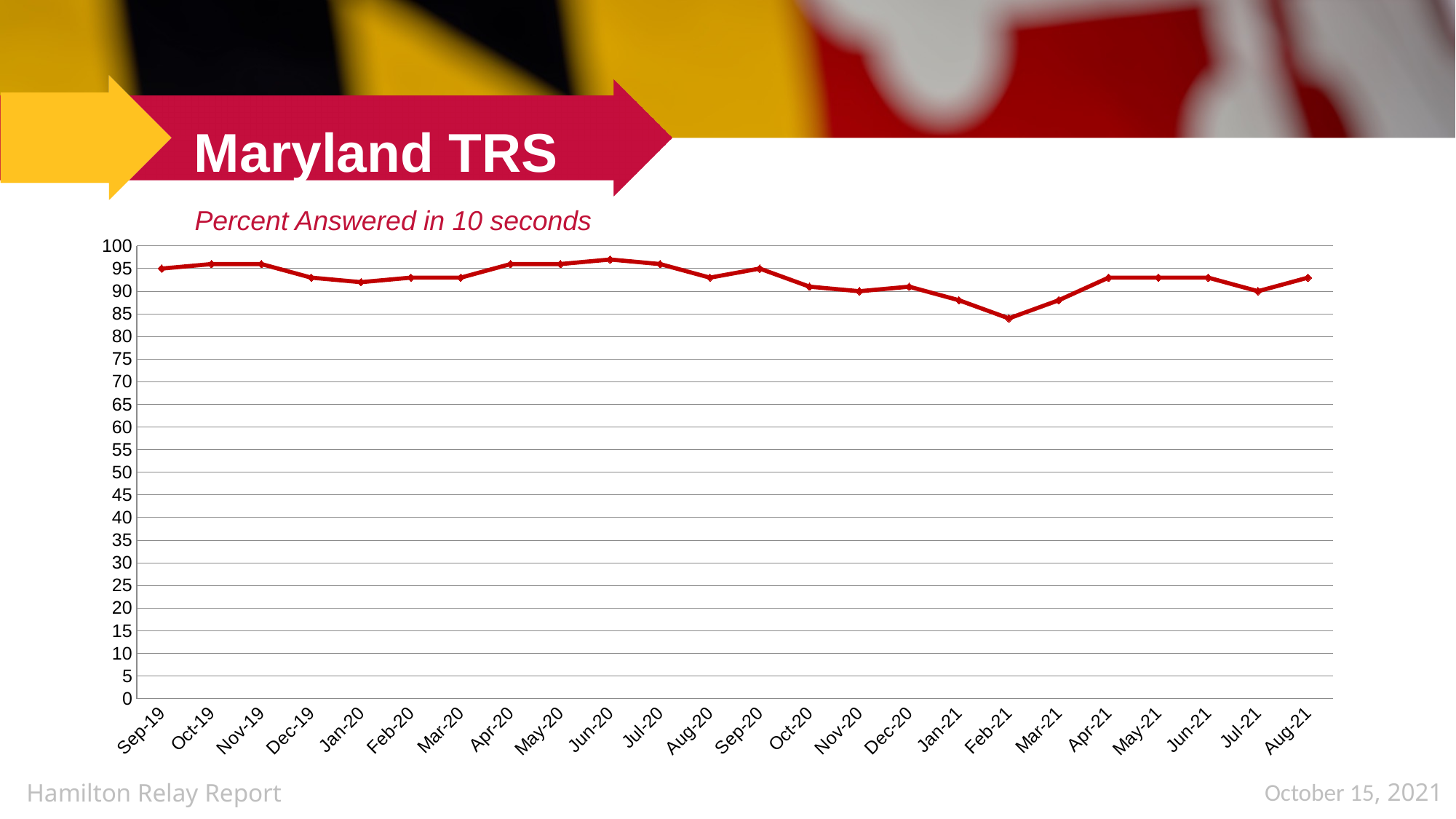
Is the value for Jan-21 greater or less than 90? less Is the value for Feb-21 greater or less than 90? less Is the value for Jun-20 greater or less than 95? greater Which is larger, the value for Oct-19 or the value for Jan-21? Oct-19 What is the title of the chart? Percent Answered in 10 seconds Do the values rise or fall from Dec-20 to Feb-21? fall Which month has the lowest percent answered in 10 seconds? Feb-21 How many monthly data points are plotted on the chart? 24 Which is larger, the value for Jun-20 or the value for Feb-21? Jun-20 What kind of chart is shown on the slide? line chart What colour is the plotted line? red